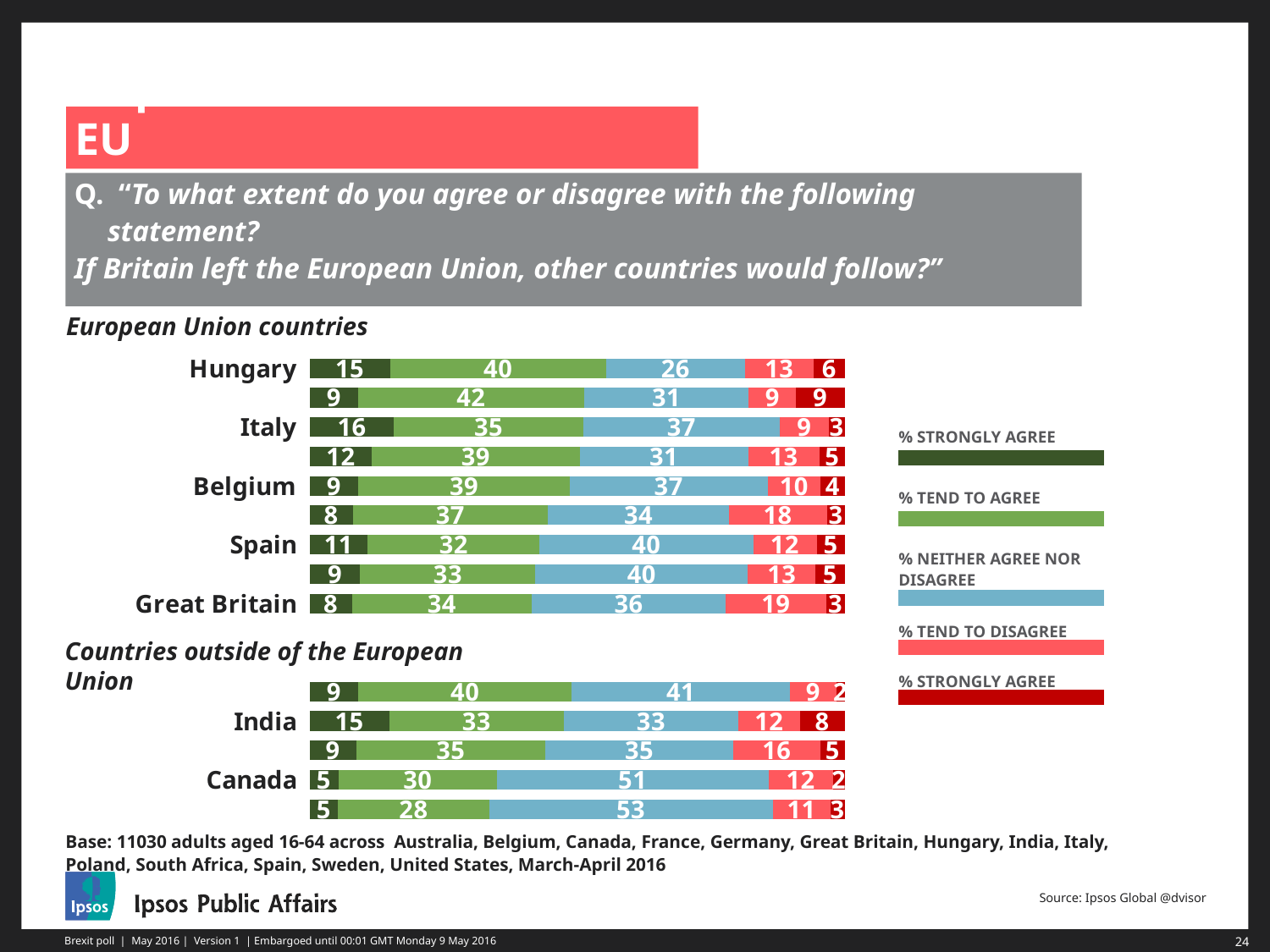
What is the total of the % Strongly Agree and % Tend to Agree values for India? 48 Which is larger, the % Tend to Disagree value for Great Britain or for Belgium? Great Britain What is the difference between the % Tend to Agree values for Hungary and Spain? 8 What is the % Strongly Agree value for Hungary? 15 How many series does the legend list? 5 Which labelled country has the lowest % Strongly Agree value? Canada Which labelled country has the highest % Neither Agree nor Disagree value? Canada What is the % Neither Agree nor Disagree value for Canada? 51 Which country is listed under the heading 'Countries outside of the European Union' together with India? Canada What is the % Tend to Agree value for Italy? 35 What is the % Tend to Disagree value for Great Britain? 19 What type of chart is shown on the slide? stacked bar chart